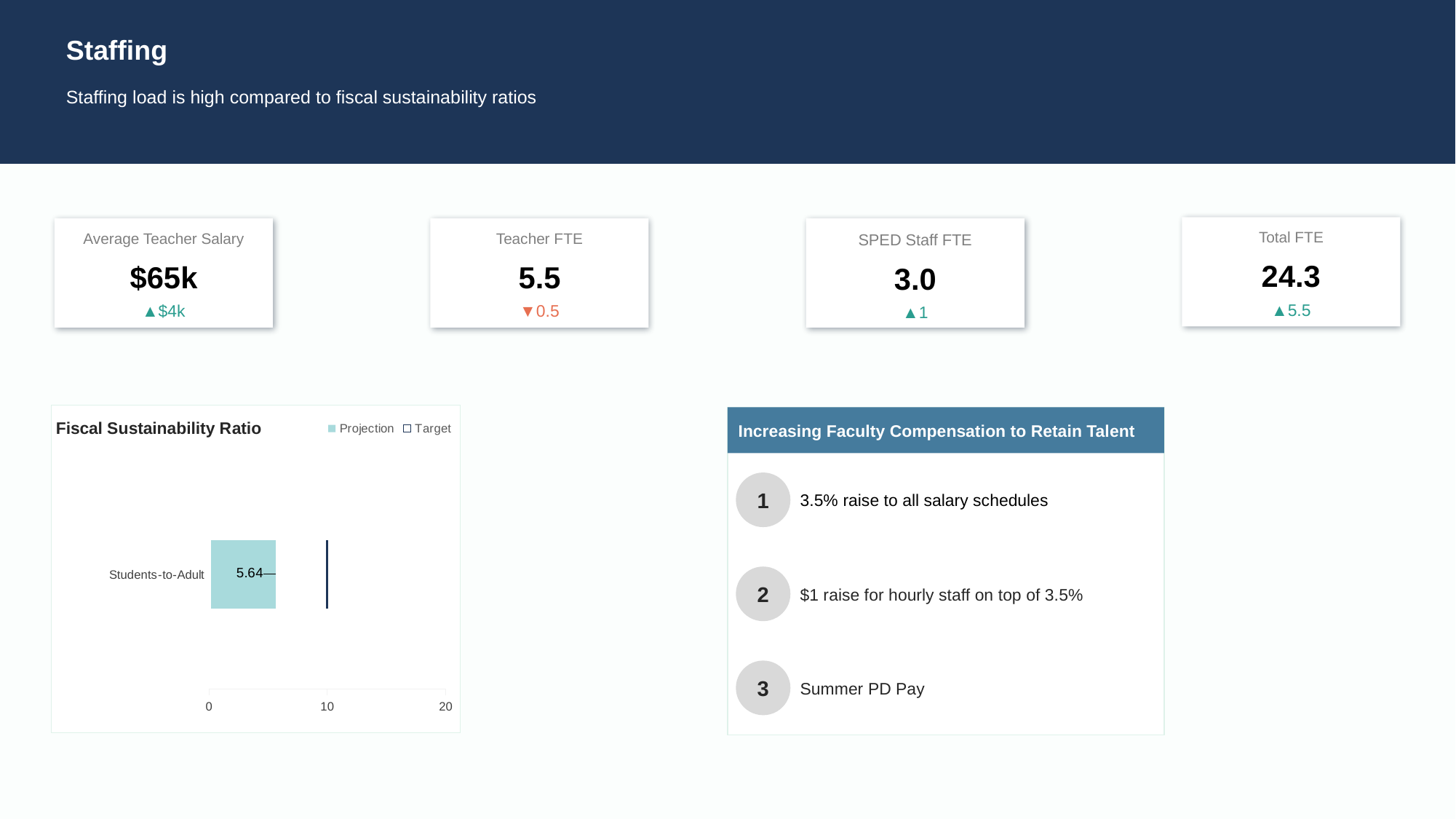
What kind of chart is the Fiscal Sustainability Ratio chart? bar chart In the Fiscal Sustainability Ratio chart, what is the Projection value for Students-to-Adult? 5.64 What is the category label on the Fiscal Sustainability Ratio chart? Students-to-Adult What are the two legend entries in the Fiscal Sustainability Ratio chart? Projection and Target In the Fiscal Sustainability Ratio chart, is the Projection value for Students-to-Adult greater or less than 10? less What is the title of the chart on the slide? Fiscal Sustainability Ratio In the Fiscal Sustainability Ratio chart, which is larger for Students-to-Adult, the Projection or the Target? Target How many series does the legend of the Fiscal Sustainability Ratio chart list? 2 In the Fiscal Sustainability Ratio chart, is the Target marker for Students-to-Adult greater or less than 5? greater How many categories are plotted in the Fiscal Sustainability Ratio chart? 1